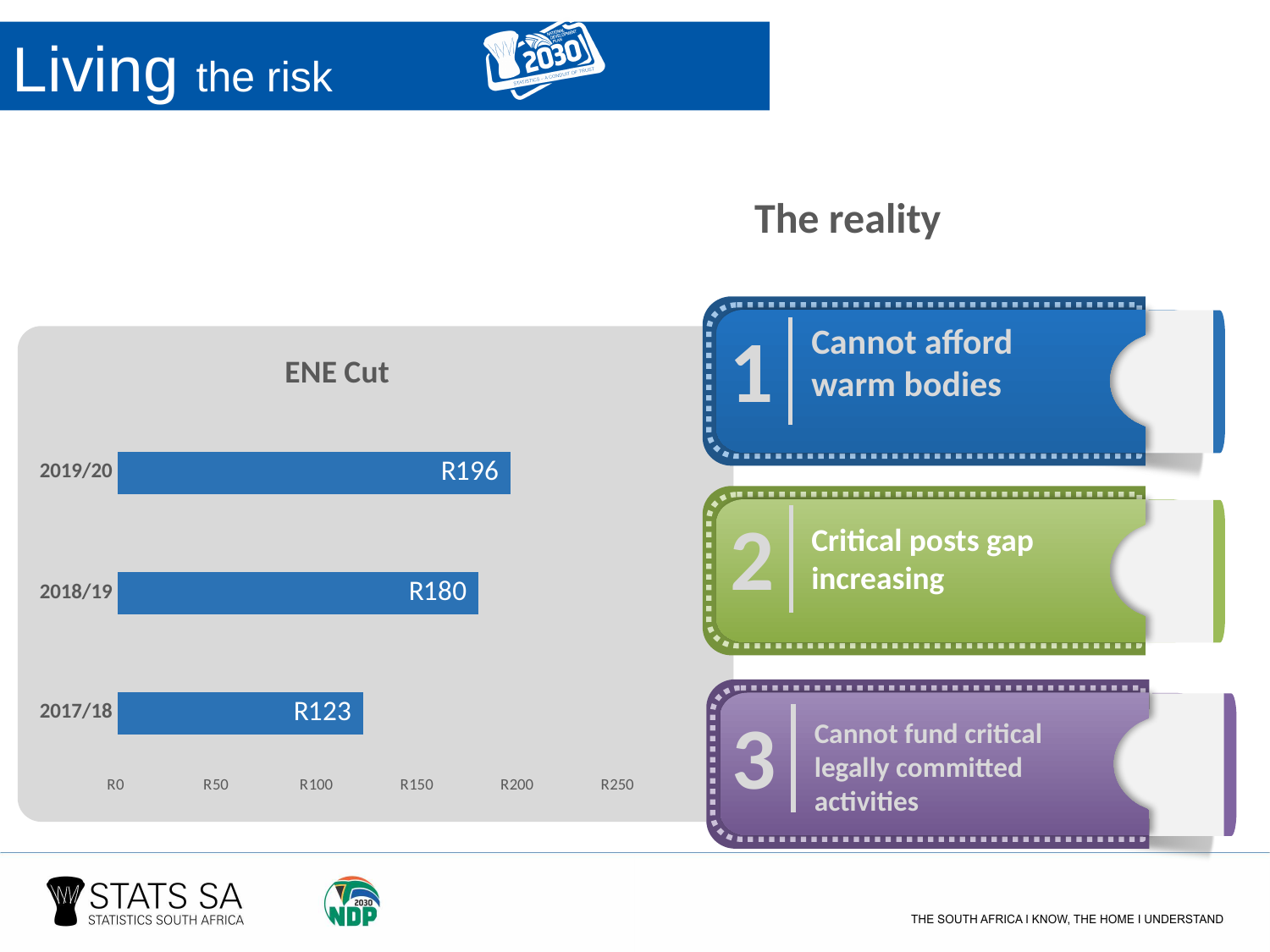
Which year has the highest ENE Cut value? 2019/20 Which year has the lowest ENE Cut value? 2017/18 What kind of chart is the ENE Cut chart? bar chart What is the value for 2019/20 in the ENE Cut chart? R196 What is the title of the chart on the slide? ENE Cut What is the difference between the ENE Cut values for 2018/19 and 2017/18? R57 Is the ENE Cut value for 2017/18 greater or less than R150? less Which is larger, the ENE Cut value for 2018/19 or for 2017/18? 2018/19 How many years are shown in the ENE Cut chart? 3 What is the value for 2018/19 in the ENE Cut chart? R180 What is the difference between the ENE Cut values for 2019/20 and 2017/18? R73 What is the value for 2017/18 in the ENE Cut chart? R123